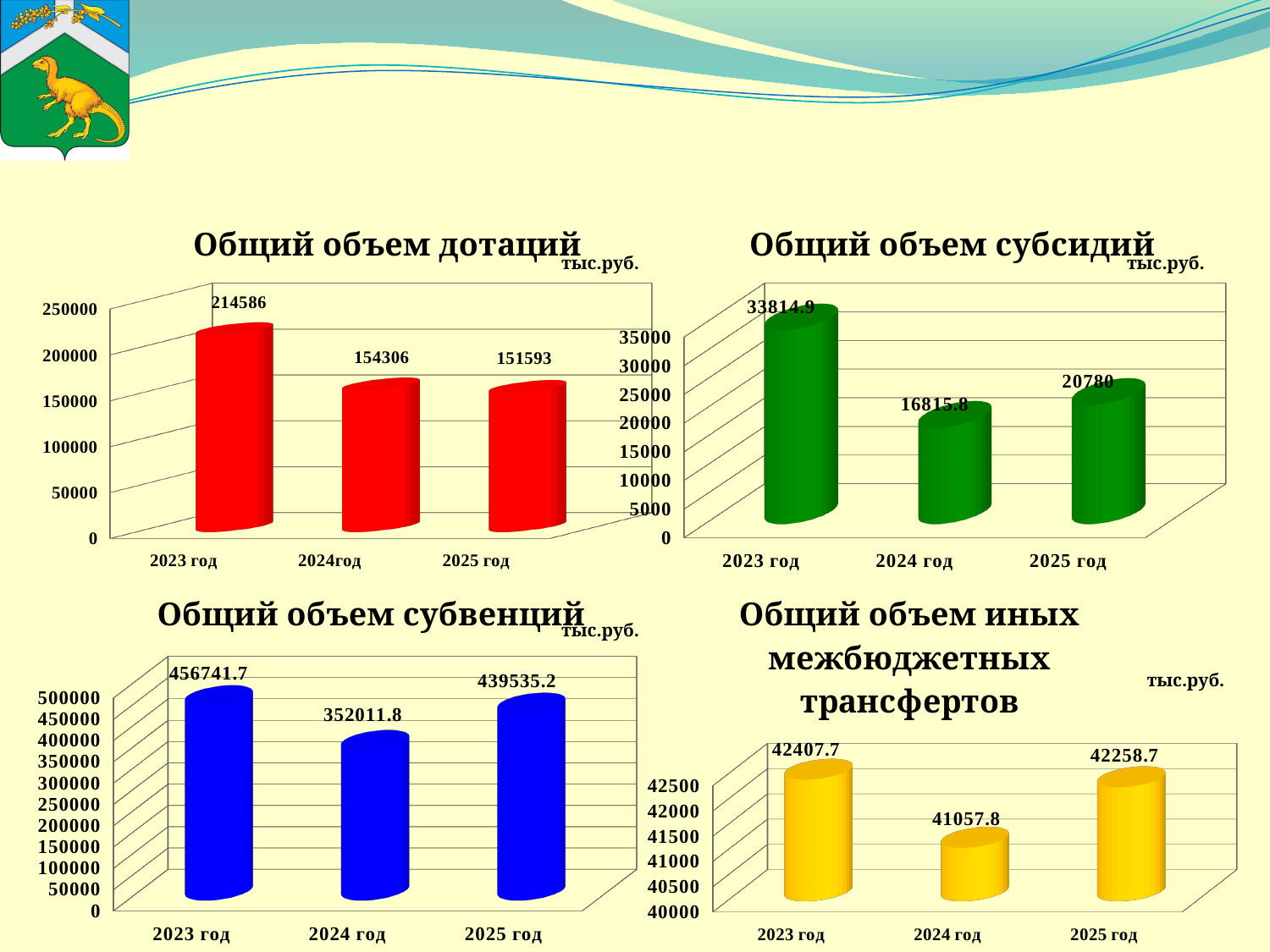
In the chart 'Общий объем дотаций', what is the difference between the values for 2023 год and 2025 год? 62993 In the chart 'Общий объем дотаций', what is the value for 2023 год? 214586 In the chart 'Общий объем дотаций', which year has the lowest value? 2025 год How many categories are shown in the chart 'Общий объем субвенций'? 3 In the chart 'Общий объем субсидий', what is the difference between the values for 2023 год and 2024 год? 16999.1 In the chart 'Общий объем субсидий', what is the value for 2024 год? 16815.8 In the chart 'Общий объем иных межбюджетных трансфертов', what is the value for 2024 год? 41057.8 What type of chart is 'Общий объем дотаций'? Bar chart In the chart 'Общий объем субвенций', what is the value for 2025 год? 439535.2 In the chart 'Общий объем иных межбюджетных трансфертов', what is the difference between the values for 2023 год and 2024 год? 1349.9 In the chart 'Общий объем субвенций', which is larger, the value for 2024 год or 2025 год? 2025 год In the chart 'Общий объем субсидий', which year has the highest value? 2023 год